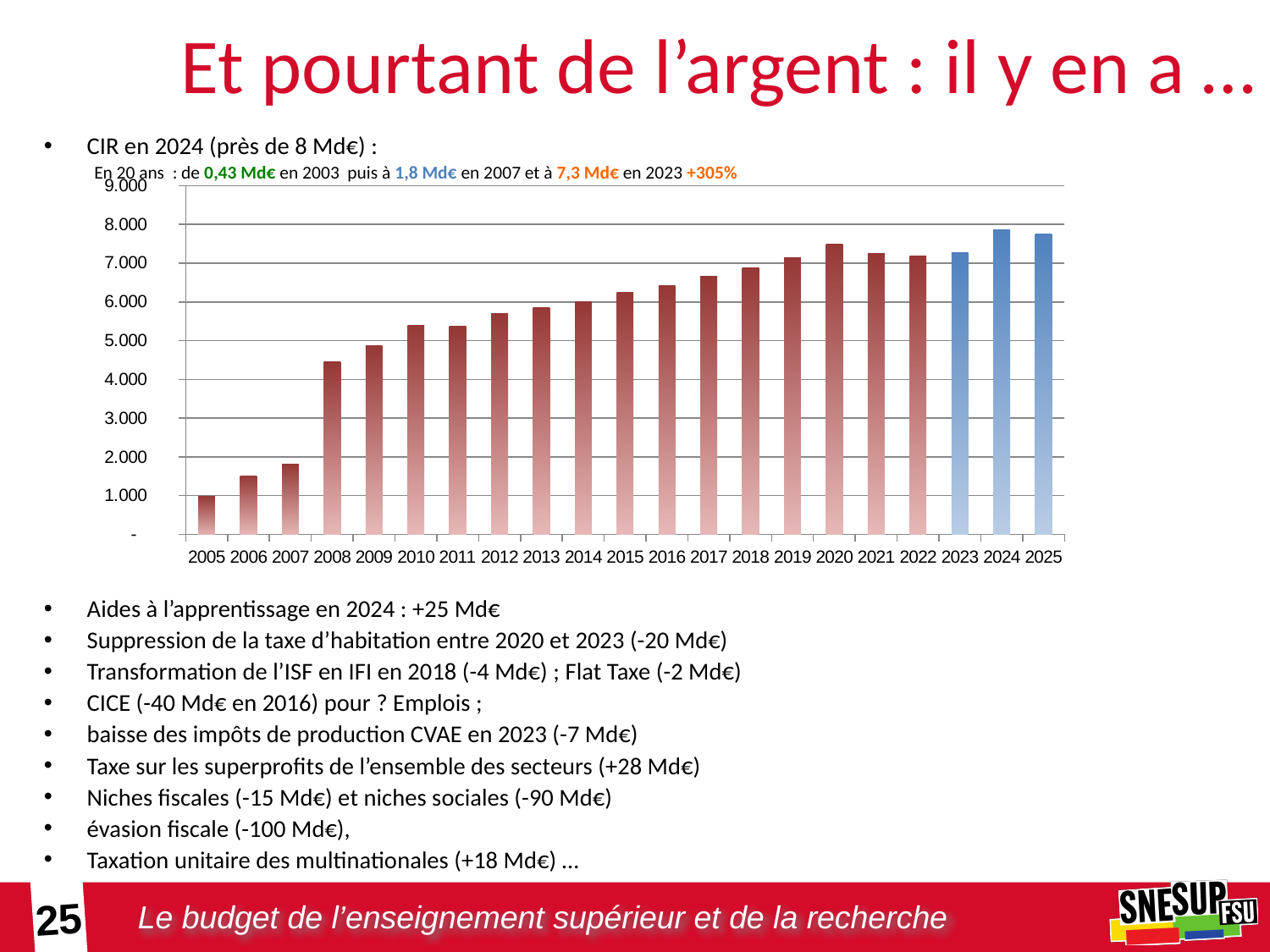
Is the value for 2012 greater or less than 6.000? less How many years are shown on the x axis of the chart? 21 Which year has the lowest bar in the chart? 2005 Is the value for 2008 greater or less than 4.000? greater What kind of chart is shown on the slide? bar chart Is the value for 2007 greater or less than 2.000? less How many bars in the chart are coloured blue rather than red? 3 Which year has the highest bar in the chart? 2024 Do the values generally rise or fall from 2005 to 2025? rise Which year has the larger value, 2007 or 2008? 2008